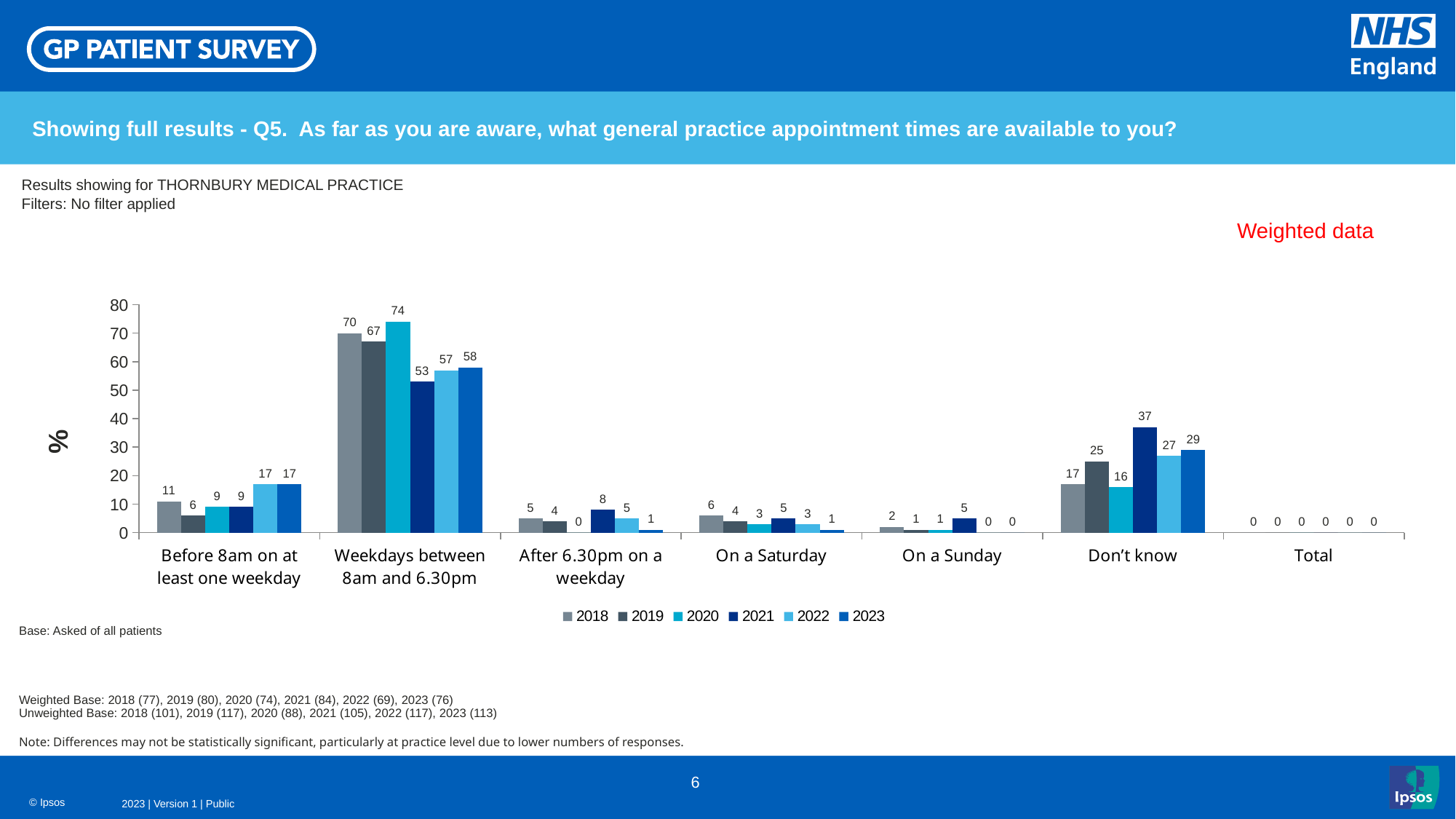
How many categories are shown on the x axis? 7 What is the difference between the 2020 and 2021 values for 'Weekdays between 8am and 6.30pm'? 21 Which year has the lowest value for 'Before 8am on at least one weekday'? 2019 Which is larger for 'Don't know': the 2019 value or the 2022 value? 2022 How many series does the legend list? 6 What kind of chart is shown on the slide? Bar chart What is the 2020 value for 'Weekdays between 8am and 6.30pm'? 74 What is the 2023 value for 'After 6.30pm on a weekday'? 1 What is the 2018 value for 'Before 8am on at least one weekday'? 11 What is the 2021 value for 'Don't know'? 37 Is the 2023 value for 'Weekdays between 8am and 6.30pm' greater or less than 50? greater Which year has the highest value for 'Weekdays between 8am and 6.30pm'? 2020